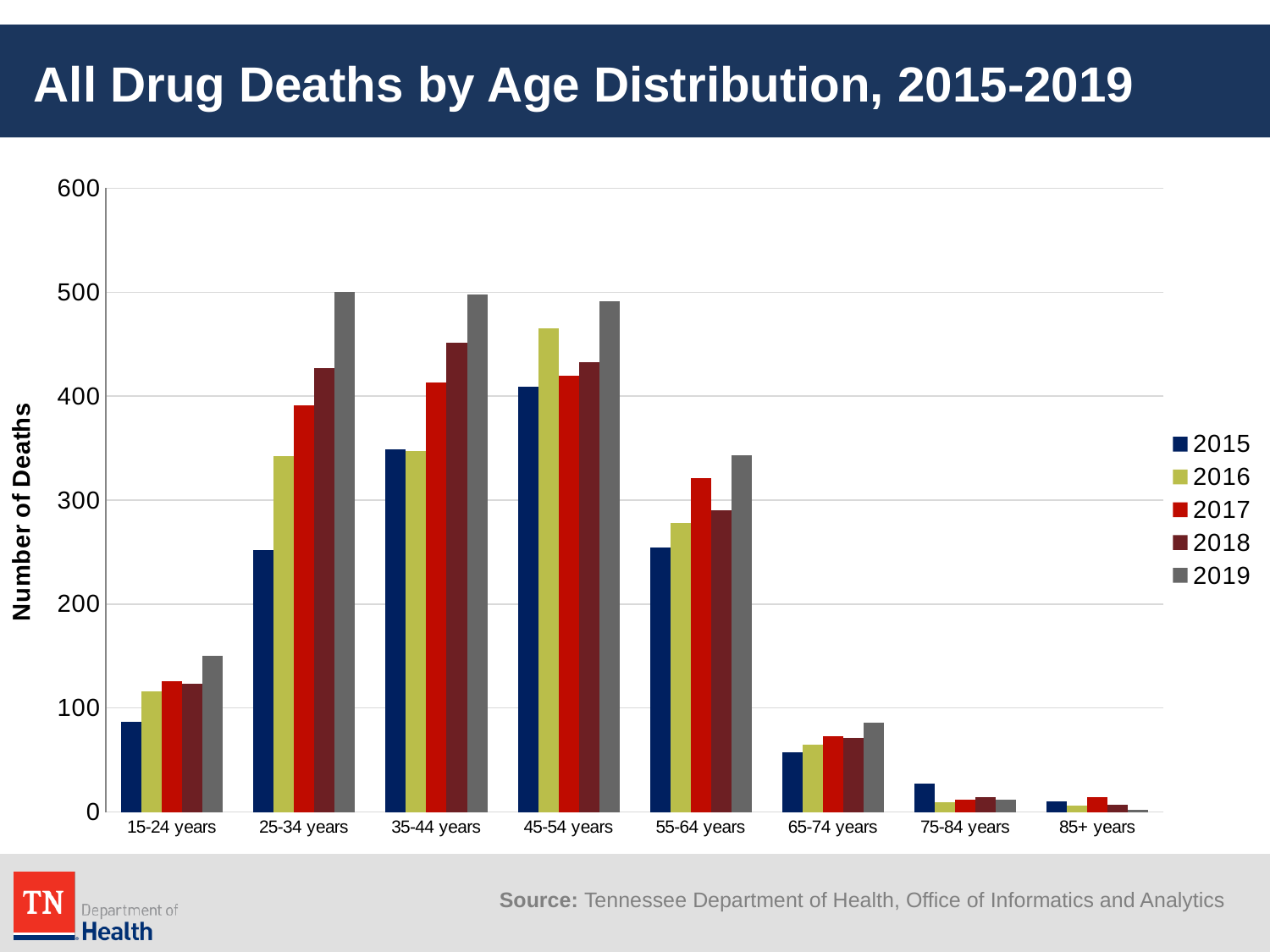
What kind of chart is shown on the slide? bar chart How many age groups are shown on the x axis? 8 Which is larger, the 2019 bar for 15-24 years or the 2019 bar for 65-74 years? 15-24 years In the 55-64 years group, which year has the highest number of deaths? 2019 Is the value for 2019 in the 25-34 years group greater or less than 400? greater What is the label on the y axis? Number of Deaths How many series does the legend list? 5 Which age group has the lowest 2019 bar? 85+ years In the 25-34 years group, do the values rise or fall from 2015 to 2019? rise Is the value for 2017 in the 55-64 years group greater or less than 300? greater In the 45-54 years group, which is larger, the 2015 bar or the 2016 bar? 2016 Is the value for 2015 in the 15-24 years group greater or less than 100? less